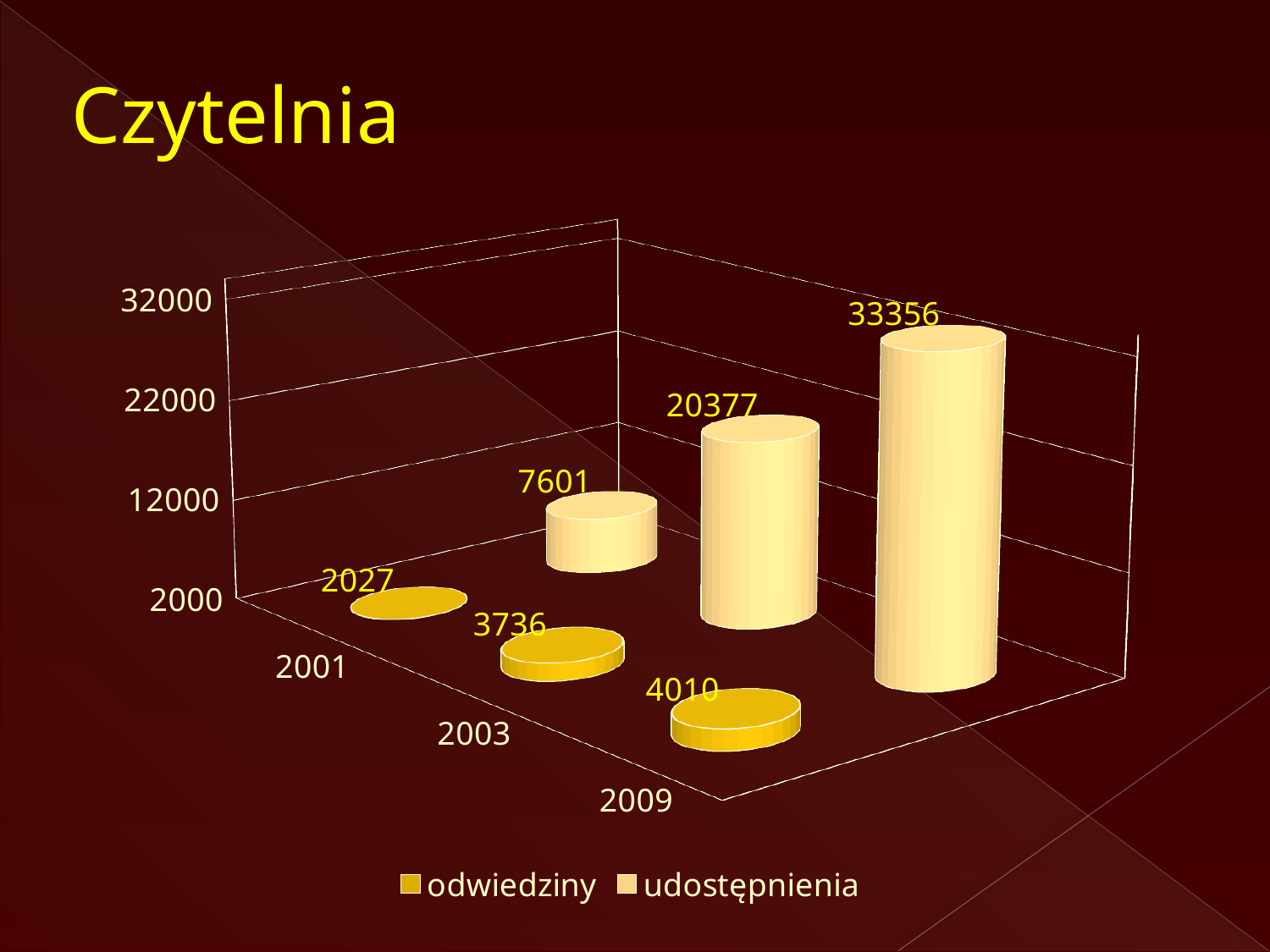
What is the value of odwiedziny for 2001? 2027 What is the difference between odwiedziny in 2003 and in 2001? 1709 How many series does the legend list? 2 How many years are shown on the category axis? 3 Which year has the lowest value for odwiedziny? 2001 What is the value of udostępnienia for 2009? 33356 What is the value of udostępnienia for 2003? 20377 What is the value of odwiedziny for 2009? 4010 Which is larger in 2001: odwiedziny or udostępnienia? udostępnienia What is the difference between udostępnienia in 2009 and in 2003? 12979 Which year has the highest value for udostępnienia? 2009 Do the udostępnienia values rise or fall from 2001 to 2009? rise